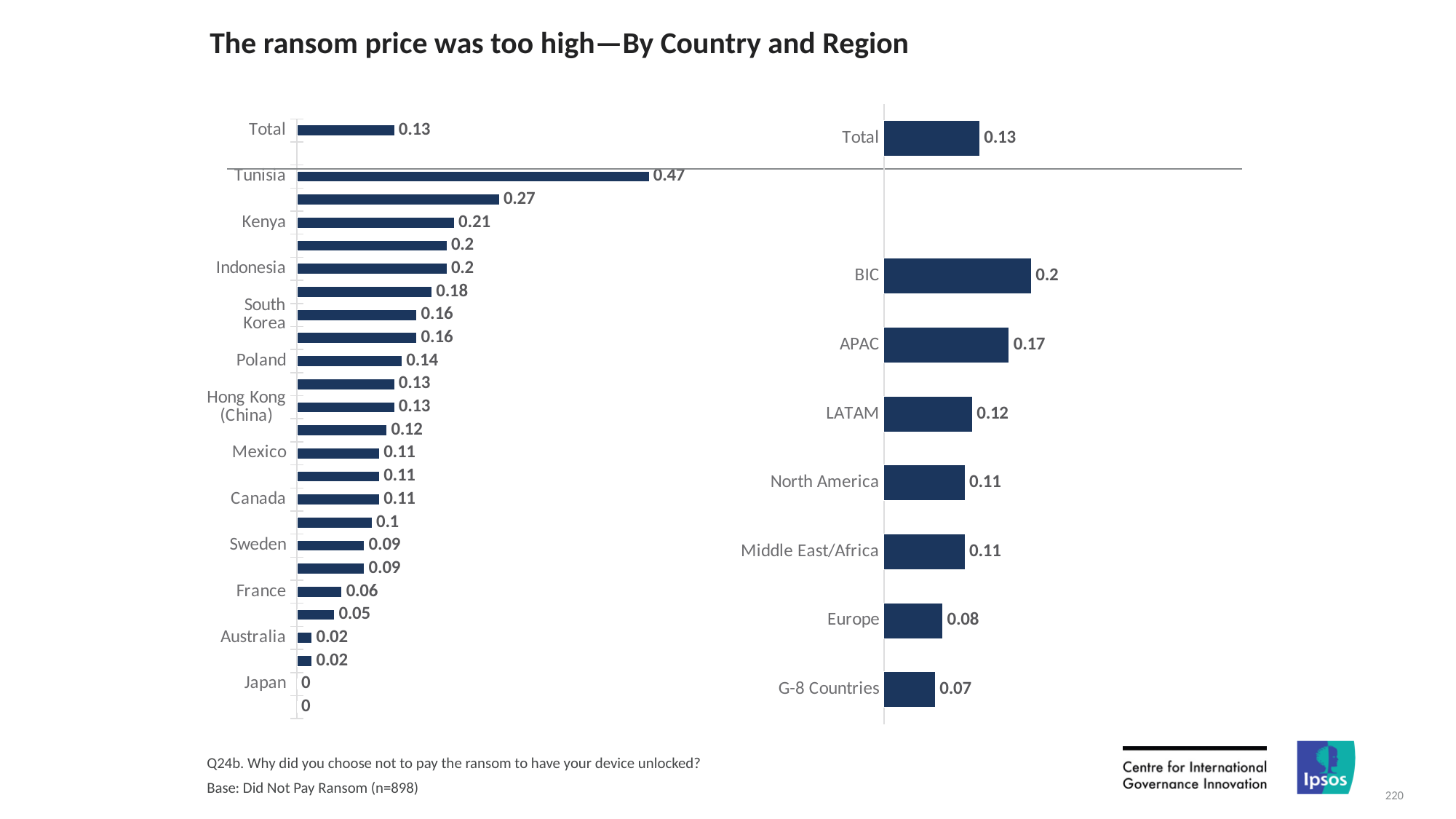
In the left chart (by country), which is larger, the value for Poland or the value for Sweden? Poland In the left chart (by country), what is the value for Japan? 0 In the right chart (by region), what is the difference between APAC and Europe? 0.09 What type of chart is used on the right side of the slide? Bar chart In the left chart (by country), what is the difference between Tunisia and Kenya? 0.26 What is the title of the slide? The ransom price was too high—By Country and Region In the right chart (by region), what is the value for BIC? 0.2 In the right chart (by region), how many bars are shown? 8 In the left chart (by country), what is the value for Kenya? 0.21 In the left chart (by country), what is the value for Tunisia? 0.47 In the left chart (by country), which country has the highest value? Tunisia In the right chart (by region), which region has the lowest value? G-8 Countries